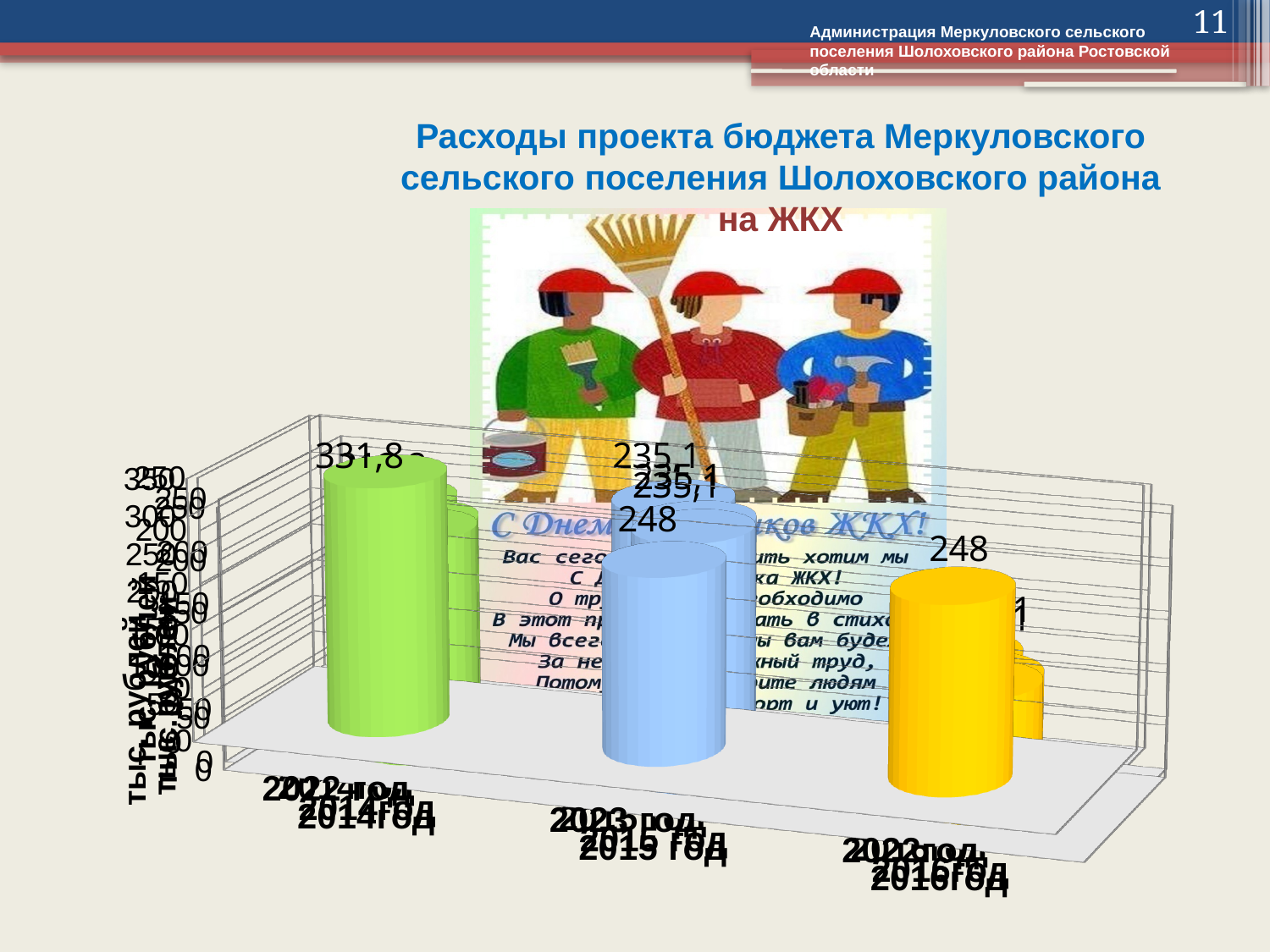
How many bars are shown in the front row of the chart? 3 Is the value of the green bar greater or less than 300? greater Which is larger, the value of the green bar or the value of the yellow bar? green bar Which coloured bar has the highest value? green What value is labelled on the green bar? 331,8 What unit label is shown on the vertical axis of the chart? тыс. рублей What kind of chart is shown on the slide? bar chart Is the value of the yellow bar greater or less than 300? less What value is labelled on the yellow bar? 248 What is the title of the chart on the slide? Расходы проекта бюджета Меркуловского сельского поселения Шолоховского района на ЖКХ What is the difference between the green bar (331,8) and the yellow bar (248)? 83,8